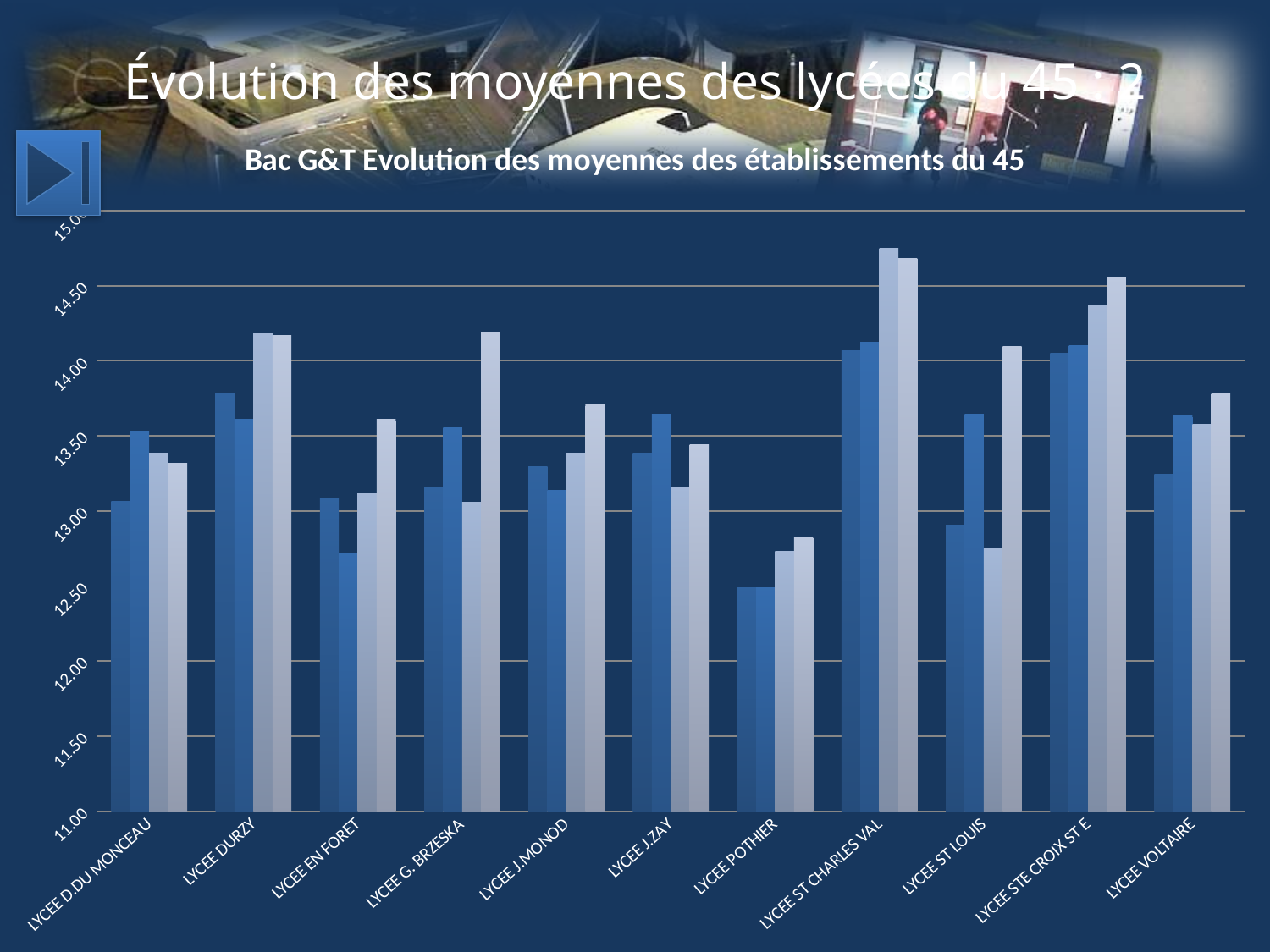
What kind of chart is shown on the slide? bar chart Which lycée has the shortest bar in the chart? LYCEE POTHIER How many bars are plotted for each lycée in the chart? 4 How many lycées (categories) are shown on the x axis of the chart? 11 Is the leftmost bar for LYCEE D.DU MONCEAU greater or less than 13.50? less What is the title of the chart? Bac G&T Evolution des moyennes des établissements du 45 Is the leftmost bar for LYCEE DURZY greater or less than 13.50? greater Which lycée has higher bars overall, LYCEE POTHIER or LYCEE ST CHARLES VAL? LYCEE ST CHARLES VAL Which lycée has the tallest bar in the chart? LYCEE ST CHARLES VAL Is the leftmost bar for LYCEE POTHIER greater or less than 13.00? less